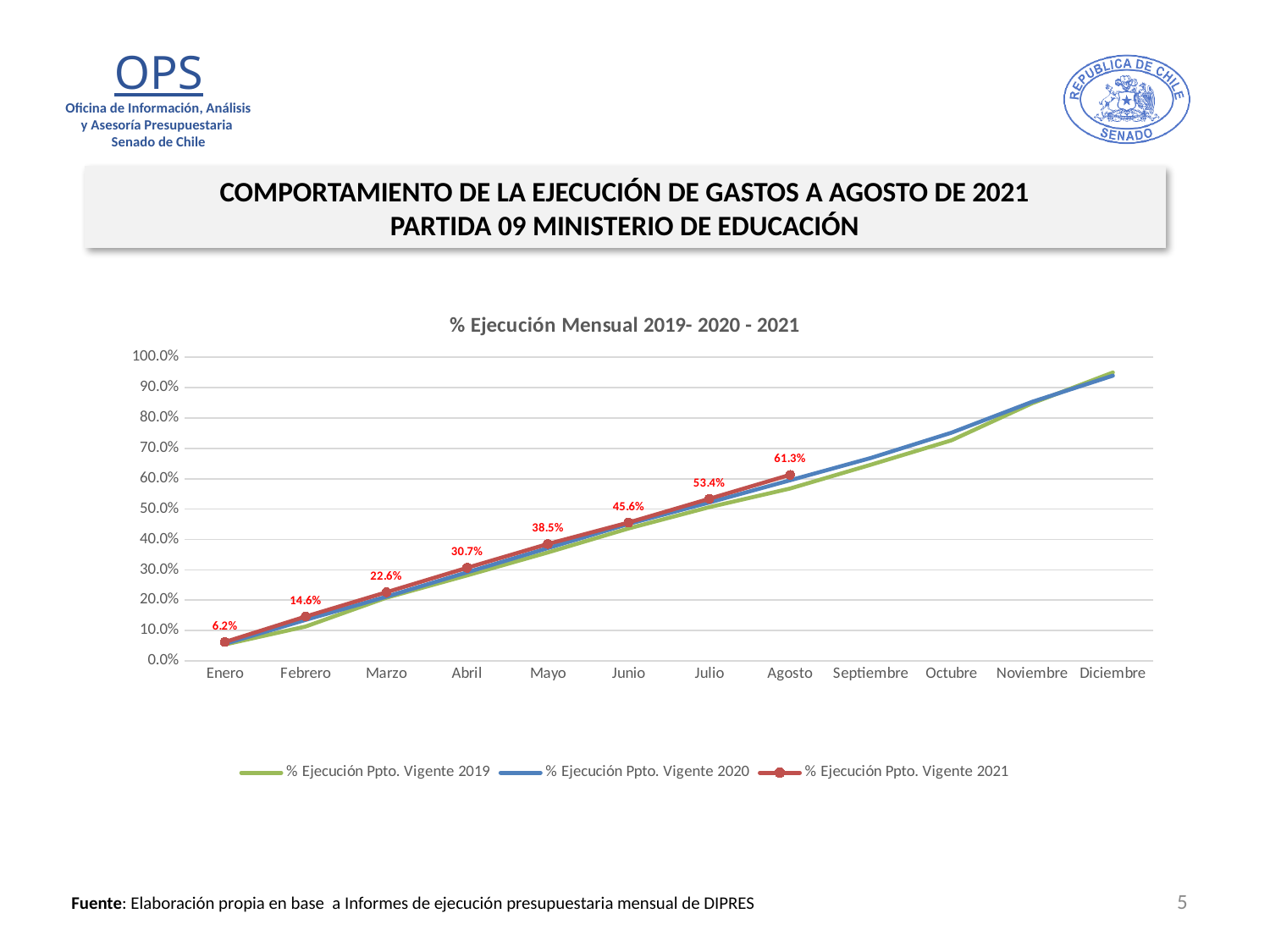
What type of chart is shown on the slide? line chart How many series does the legend list? 3 Does the % Ejecución Ppto. Vigente 2021 series rise or fall from Enero to Agosto? rise What is the value of % Ejecución Ppto. Vigente 2021 for Agosto? 61.3% What is the value of % Ejecución Ppto. Vigente 2021 for Enero? 6.2% What is the value of % Ejecución Ppto. Vigente 2021 for Abril? 30.7% What is the title of the chart? % Ejecución Mensual 2019- 2020 - 2021 Which month has the highest value for % Ejecución Ppto. Vigente 2021? Agosto What is the difference between the 2021 values for Junio and Enero? 39.4% What is the difference between the 2021 values for Agosto and Julio? 7.9% Is the value for % Ejecución Ppto. Vigente 2020 in Diciembre greater or less than 90.0%? greater How many months are shown on the x axis? 12